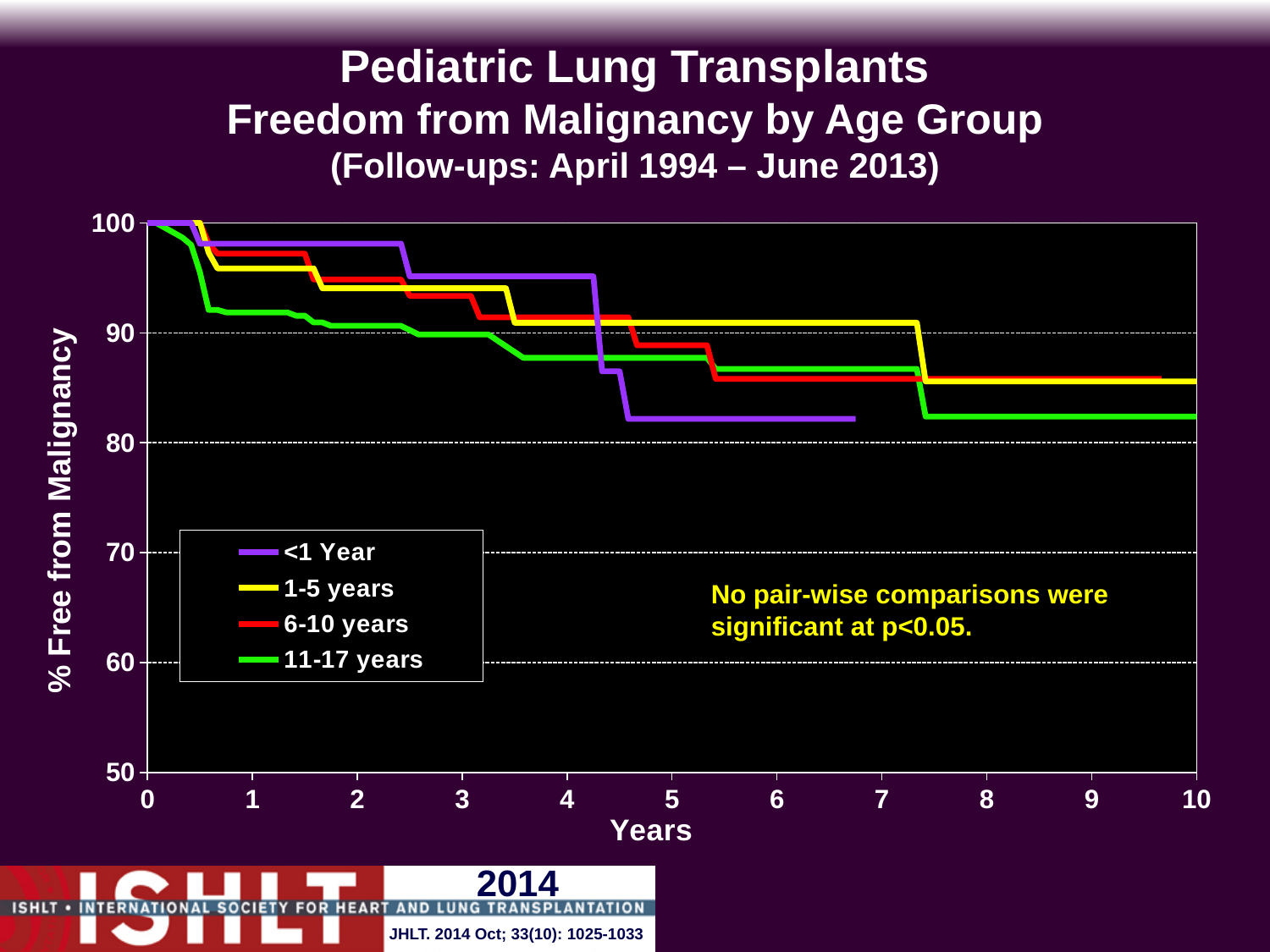
At 6 years, which group has the higher value: <1 Year or 1-5 years? 1-5 years What follow-up period is given in the chart title? April 1994 – June 2013 Is the value for the 11-17 years group at 10 years greater or less than 80? greater Is the value for the 1-5 years group at 10 years greater or less than 90? less Is the value for the <1 Year group at 6 years greater or less than 90? less What kind of chart is shown on the slide? line chart Which age group has the lowest value at 6 years? <1 Year At 1 year, which group has the higher value: <1 Year or 11-17 years? <1 Year Do the values for the 11-17 years group rise or fall as the years increase? fall How many age groups does the legend list? 4